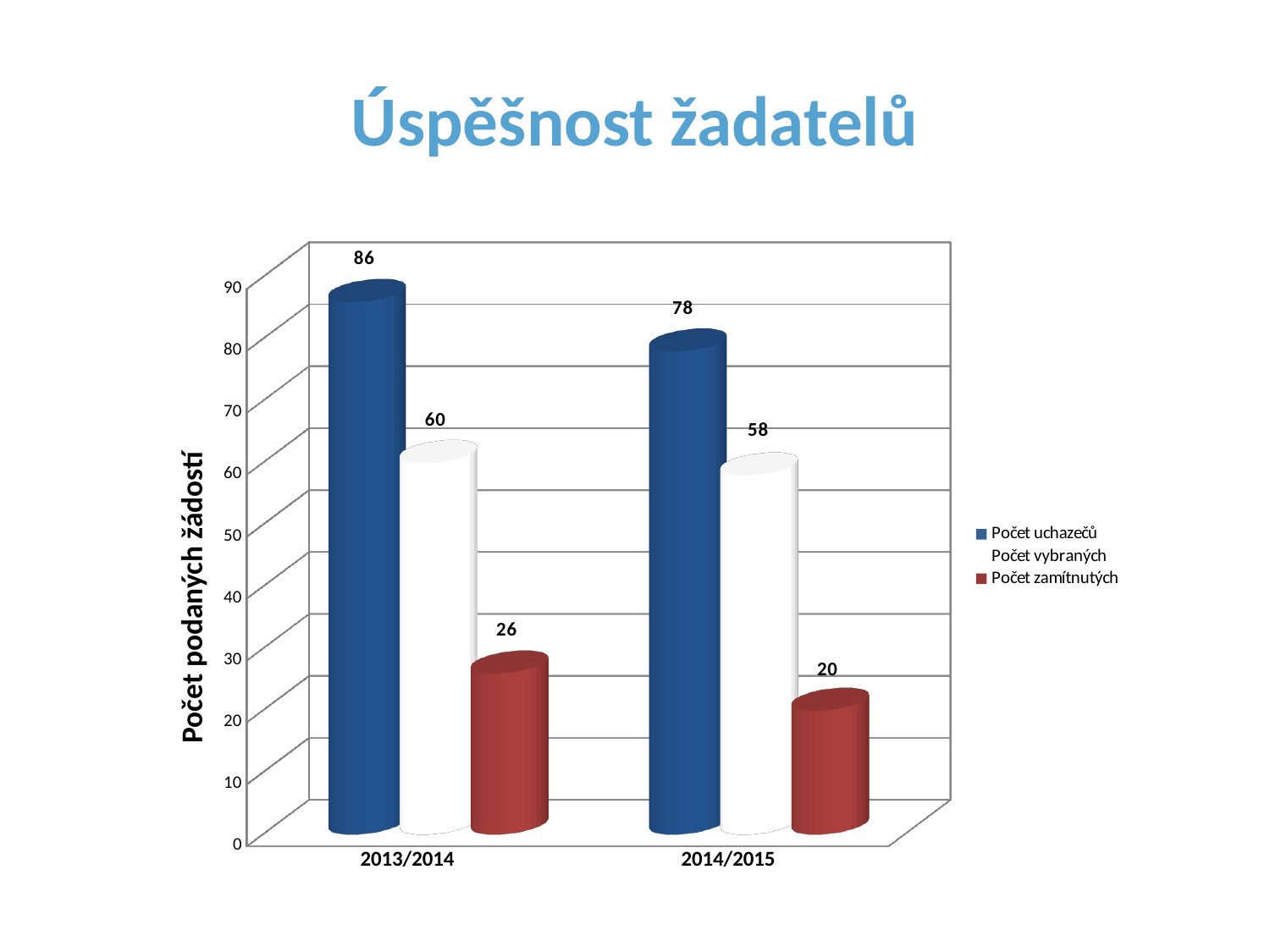
What is the value of Počet zamítnutých for 2013/2014? 26 What kind of chart is shown on the slide? bar chart What is the value of Počet uchazečů for 2013/2014? 86 How many series does the legend list? 3 What is the value of Počet vybraných for 2014/2015? 58 How many categories are shown on the x axis? 2 Is Počet vybraných in 2013/2014 larger or smaller than Počet vybraných in 2014/2015? larger What is the difference between Počet uchazečů in 2013/2014 and 2014/2015? 8 What is the difference between Počet zamítnutých in 2013/2014 and 2014/2015? 6 Which year has the higher value for Počet uchazečů? 2013/2014 Which series has the lowest value in 2014/2015? Počet zamítnutých What is the title of the chart? Úspěšnost žadatelů